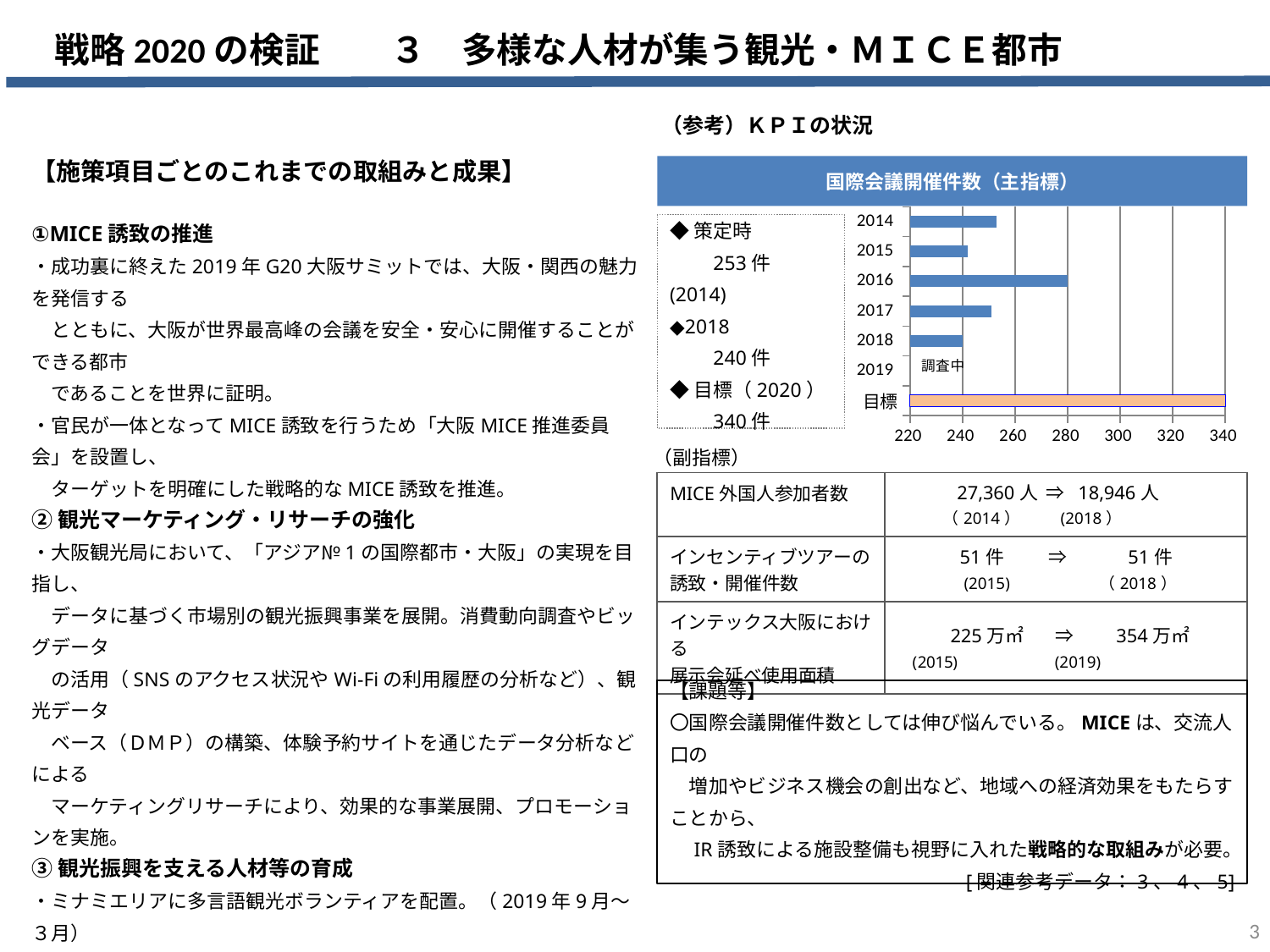
In the 国際会議開催件数 chart, what is the value of the 目標 (2020) bar? 340件 In the 国際会議開催件数 chart, is the value for 2017 greater or less than 260? less In the 国際会議開催件数 chart, what is the difference between the 目標 value and the 2018 value? 100件 In the 国際会議開催件数 chart, which is larger, the value for 2016 or the value for 2017? 2016 In the 国際会議開催件数 chart, is the value for 2016 greater or less than 260? greater In the 国際会議開催件数 chart, what is the value for 2018? 240件 What type of chart is shown under the title 国際会議開催件数（主指標）? bar chart In the 国際会議開催件数 chart, what is the value for 2014 (策定時)? 253件 In the 国際会議開催件数 chart, what is the difference between the 2014 value and the 2018 value? 13件 In the 国際会議開催件数 chart, which category has the longest bar? 目標 In the 国際会議開催件数 chart, what label is shown in place of a bar for 2019? 調査中 In the 国際会議開催件数 chart, which year from 2014 to 2018 has the longest bar? 2016